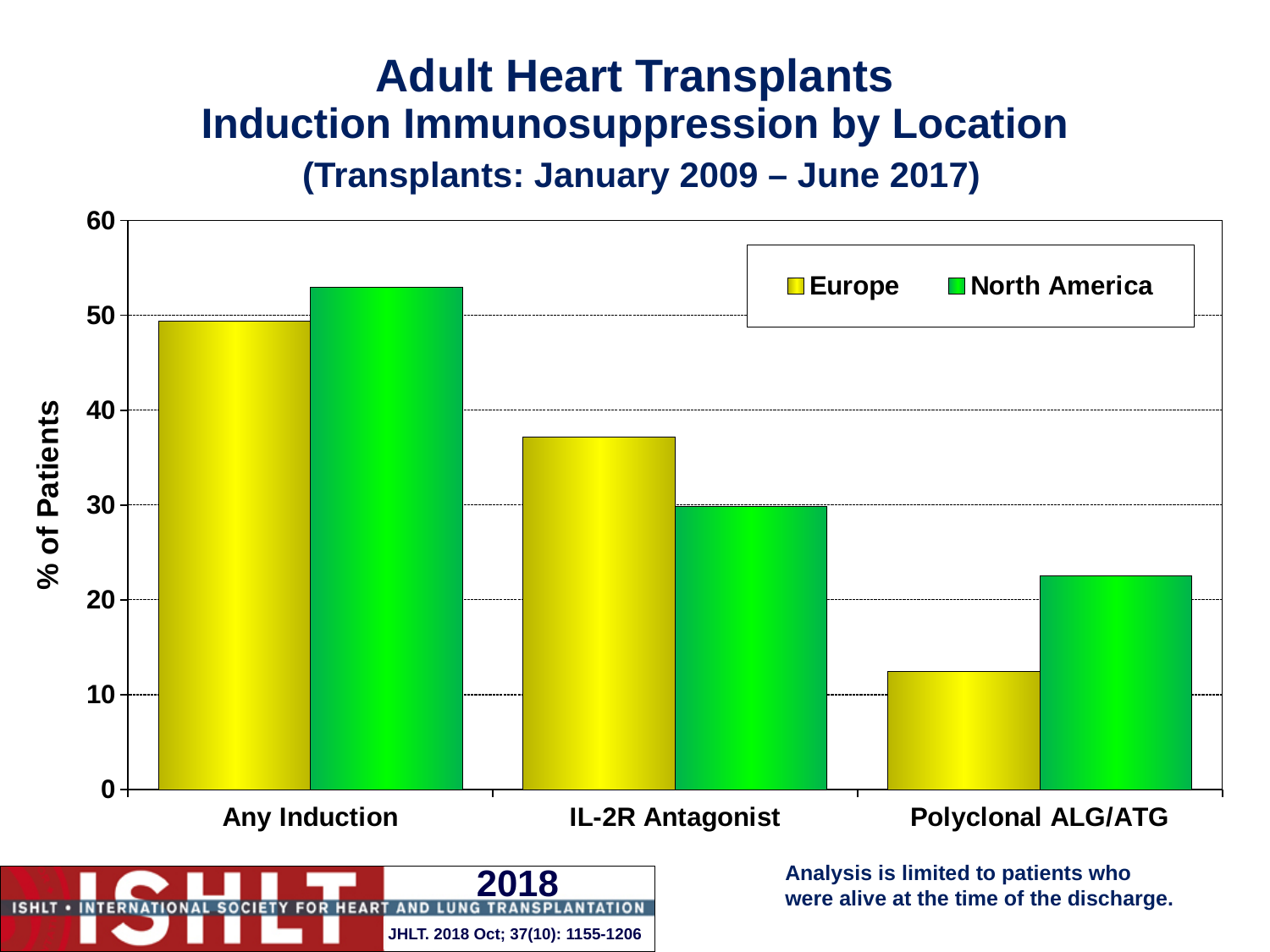
What is the y-axis label of the chart? % of Patients In the Polyclonal ALG/ATG category, which region has the larger value, Europe or North America? North America Is the value for North America in the Polyclonal ALG/ATG category greater or less than 20? greater How many series does the legend list? 2 Is the value for North America in the Any Induction category greater or less than 50? greater In the IL-2R Antagonist category, which region has the larger value, Europe or North America? Europe Which series is shown in green? North America Which category has the lowest value for Europe? Polyclonal ALG/ATG Is the value for Europe in the Polyclonal ALG/ATG category greater or less than 10? greater How many categories are shown on the x axis? 3 What kind of chart is shown on the slide? bar chart